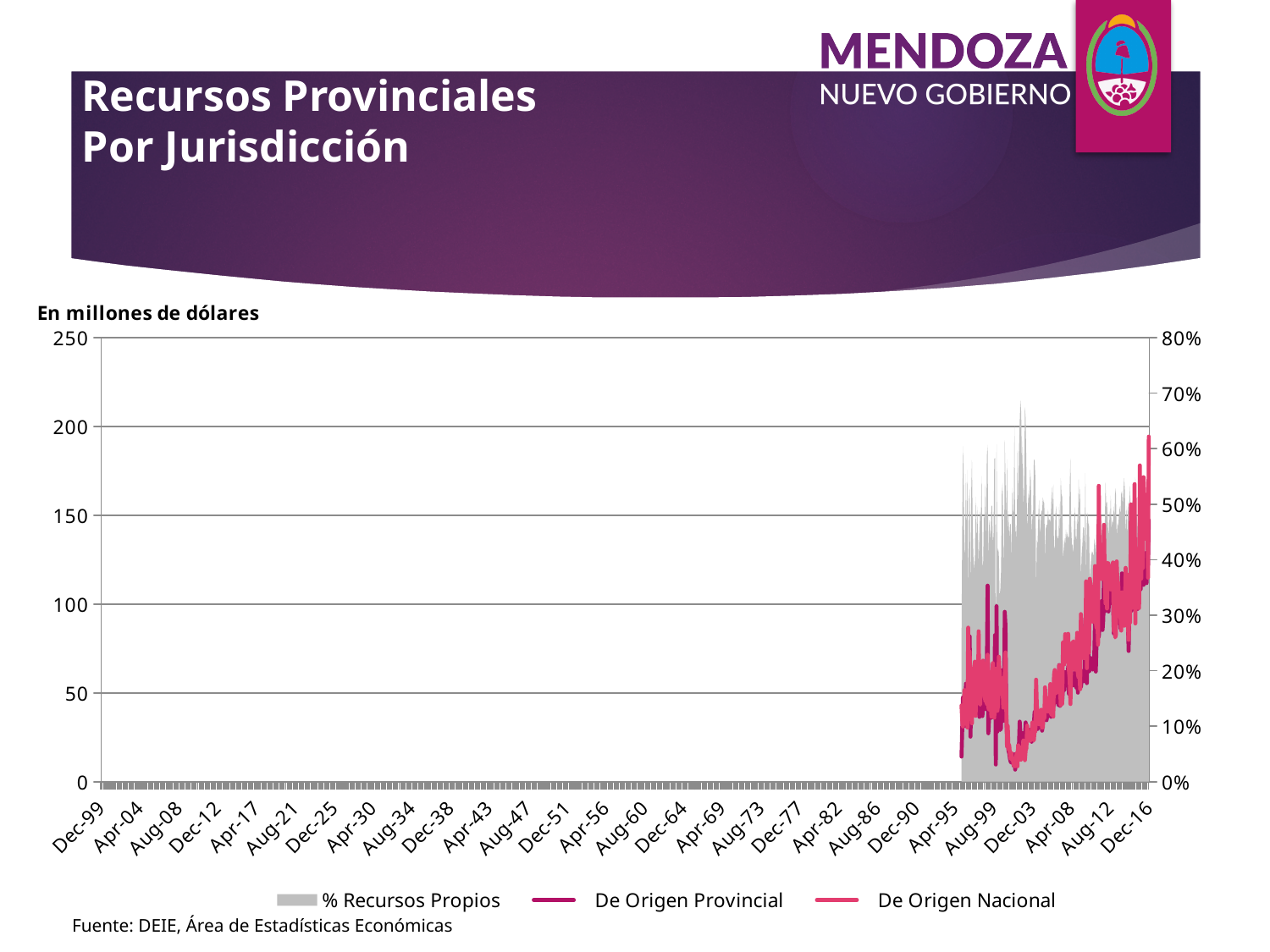
What source is cited below the chart? DEIE, Área de Estadísticas Económicas Does the De Origen Nacional line generally rise or fall between Dec-03 and Dec-16? Rise Which series is drawn as the grey shaded area? % Recursos Propios Does the De Origen Provincial line generally rise or fall between Dec-03 and Dec-16? Rise How many series does the chart legend list? 3 What kind of chart is shown on the slide? Combined area and line chart